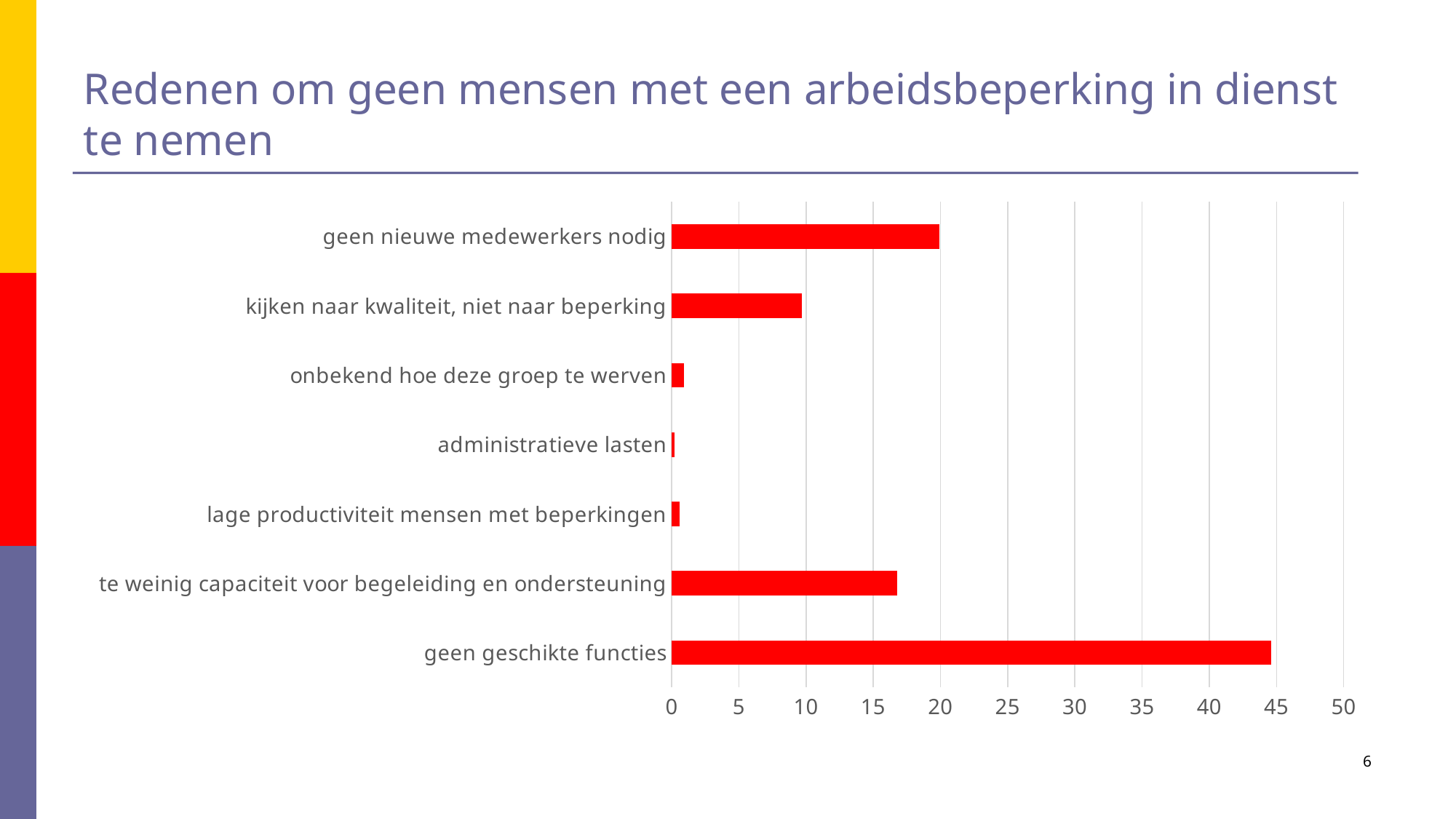
Is the value for 'kijken naar kwaliteit, niet naar beperking' greater or less than 15? less What is the title of the slide containing the chart? Redenen om geen mensen met een arbeidsbeperking in dienst te nemen Which has a larger value: 'geen nieuwe medewerkers nodig' or 'te weinig capaciteit voor begeleiding en ondersteuning'? geen nieuwe medewerkers nodig Which has a larger value: 'kijken naar kwaliteit, niet naar beperking' or 'te weinig capaciteit voor begeleiding en ondersteuning'? te weinig capaciteit voor begeleiding en ondersteuning What kind of chart is shown on the slide? bar chart Is the value for 'onbekend hoe deze groep te werven' greater or less than 5? less What is the maximum value shown on the horizontal axis of the chart? 50 Is the value for 'te weinig capaciteit voor begeleiding en ondersteuning' greater or less than 15? greater Which reason has the highest value in the chart? geen geschikte functies How many categories (reasons) are shown in the chart? 7